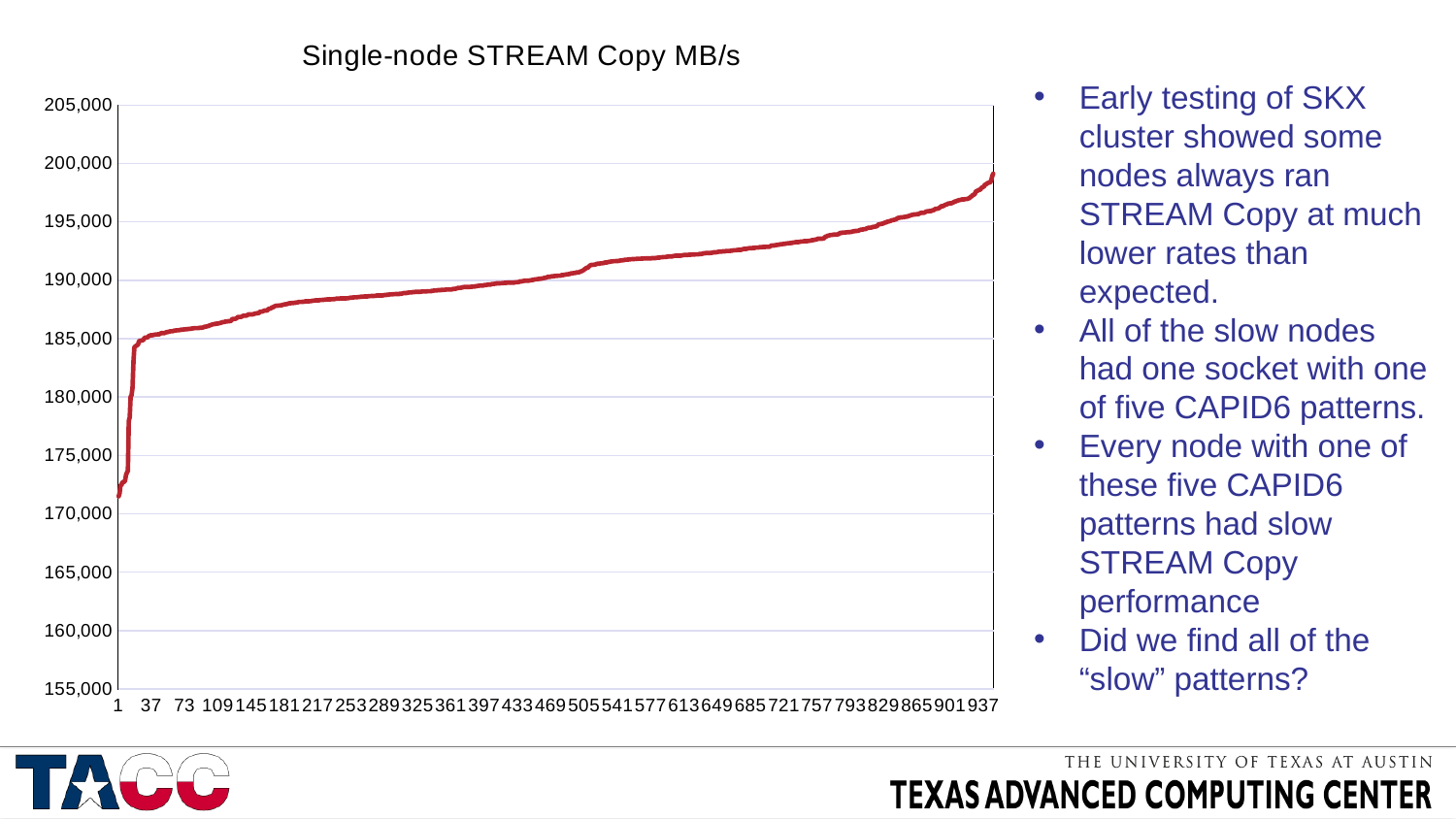
How many tick labels are shown on the x axis? 27 Is the value at x = 1 greater or less than 175,000? less Is the value at x = 901 greater or less than 195,000? greater Is the value at x = 937 greater or less than 195,000? greater What kind of chart is shown on the slide? line chart What is the highest value labelled on the y axis? 205,000 Do the values rise or fall as you move from left to right along the x axis? rise At which x-axis label does the line have its lowest value? 1 What is the title of the chart? Single-node STREAM Copy MB/s